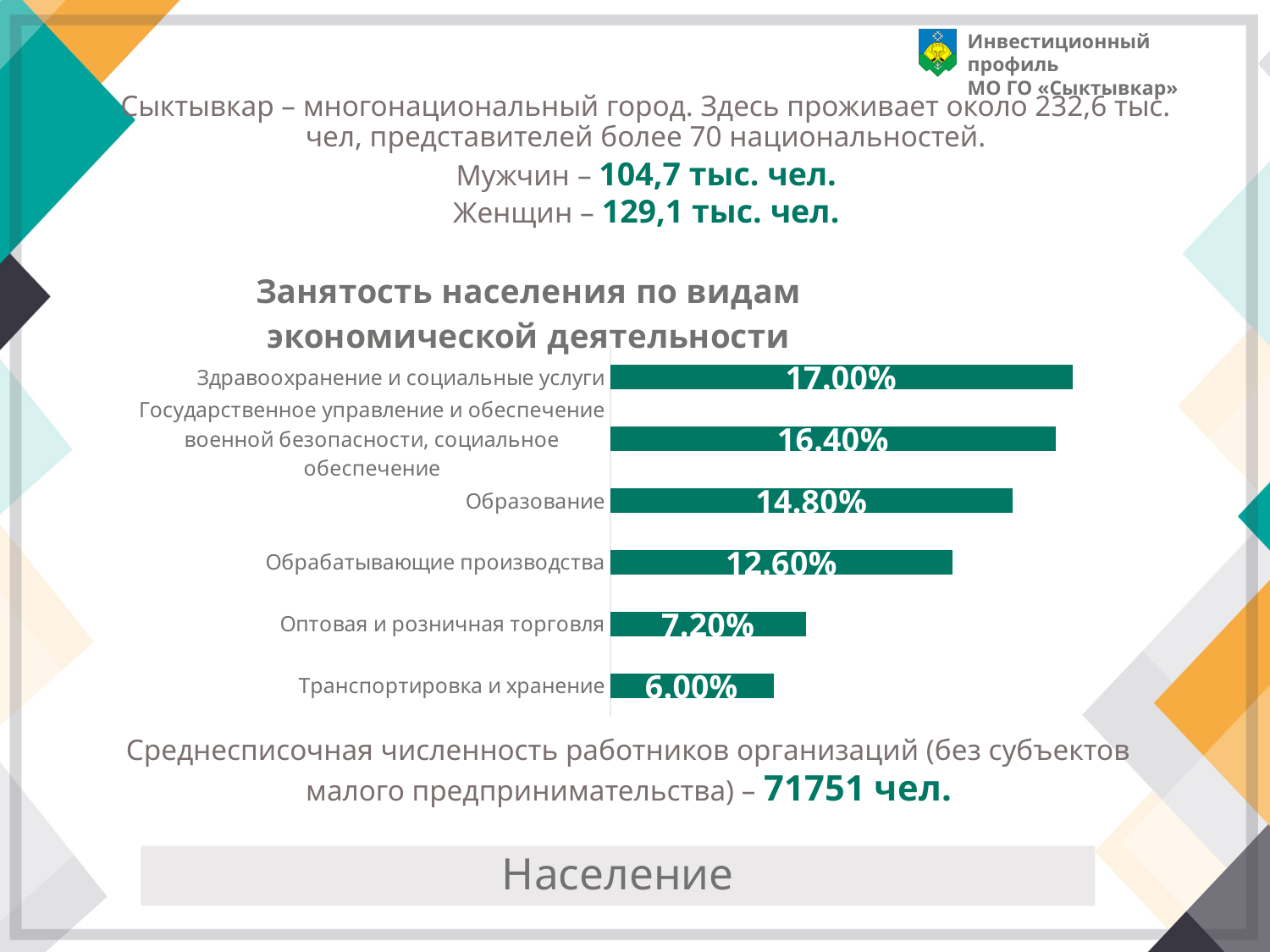
What is the difference between Обрабатывающие производства and Транспортировка и хранение? 6.60% Which category has the highest value? Здравоохранение и социальные услуги What is the value for Образование? 14.80% What is the value for Транспортировка и хранение? 6.00% What is the value for Здравоохранение и социальные услуги? 17.00% Which is larger: Обрабатывающие производства or Оптовая и розничная торговля? Обрабатывающие производства What is the difference between Здравоохранение и социальные услуги and Образование? 2.20% What is the title of the chart? Занятость населения по видам экономической деятельности How many categories are shown in the chart? 6 Which category has the lowest value? Транспортировка и хранение What is the value for Оптовая и розничная торговля? 7.20% What kind of chart is this? Bar chart